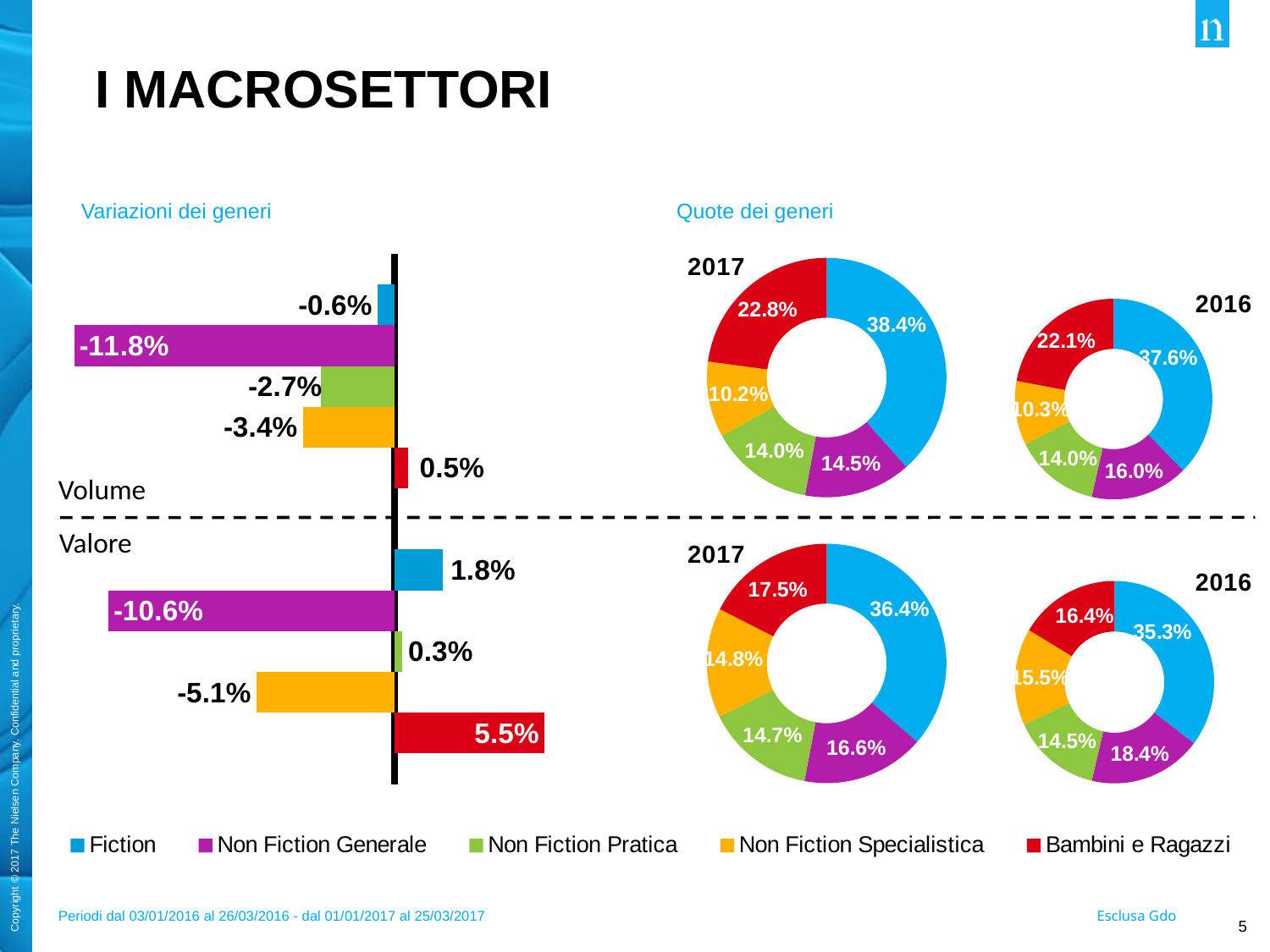
How many series does the legend at the bottom of the slide list? 5 What kind of chart is 'Variazioni dei generi'? bar chart In the 'Variazioni dei generi' bar chart, which genre has the highest Valore variation? Bambini e Ragazzi In the 2016 Valore donut chart under 'Quote dei generi', what share does Non Fiction Generale have? 18.4% In the 2017 Valore donut chart under 'Quote dei generi', which genre has the largest share? Fiction In the 'Variazioni dei generi' bar chart, what is the Valore variation for Bambini e Ragazzi? 5.5% In the 'Variazioni dei generi' bar chart, what is the Volume variation for Non Fiction Generale? -11.8% In the 'Variazioni dei generi' bar chart, which genre has the lowest Volume variation? Non Fiction Generale In the 2016 Volume donut chart under 'Quote dei generi', which genre has the smallest share? Non Fiction Specialistica In the 2017 Volume donut chart under 'Quote dei generi', what share does Fiction have? 38.4% In the 'Variazioni dei generi' bar chart, what is the difference between the Valore variation of Fiction (1.8%) and Non Fiction Pratica (0.3%)? 1.5 percentage points In the 'Variazioni dei generi' bar chart, is the Volume variation for Non Fiction Specialistica larger or smaller than that for Non Fiction Pratica? smaller